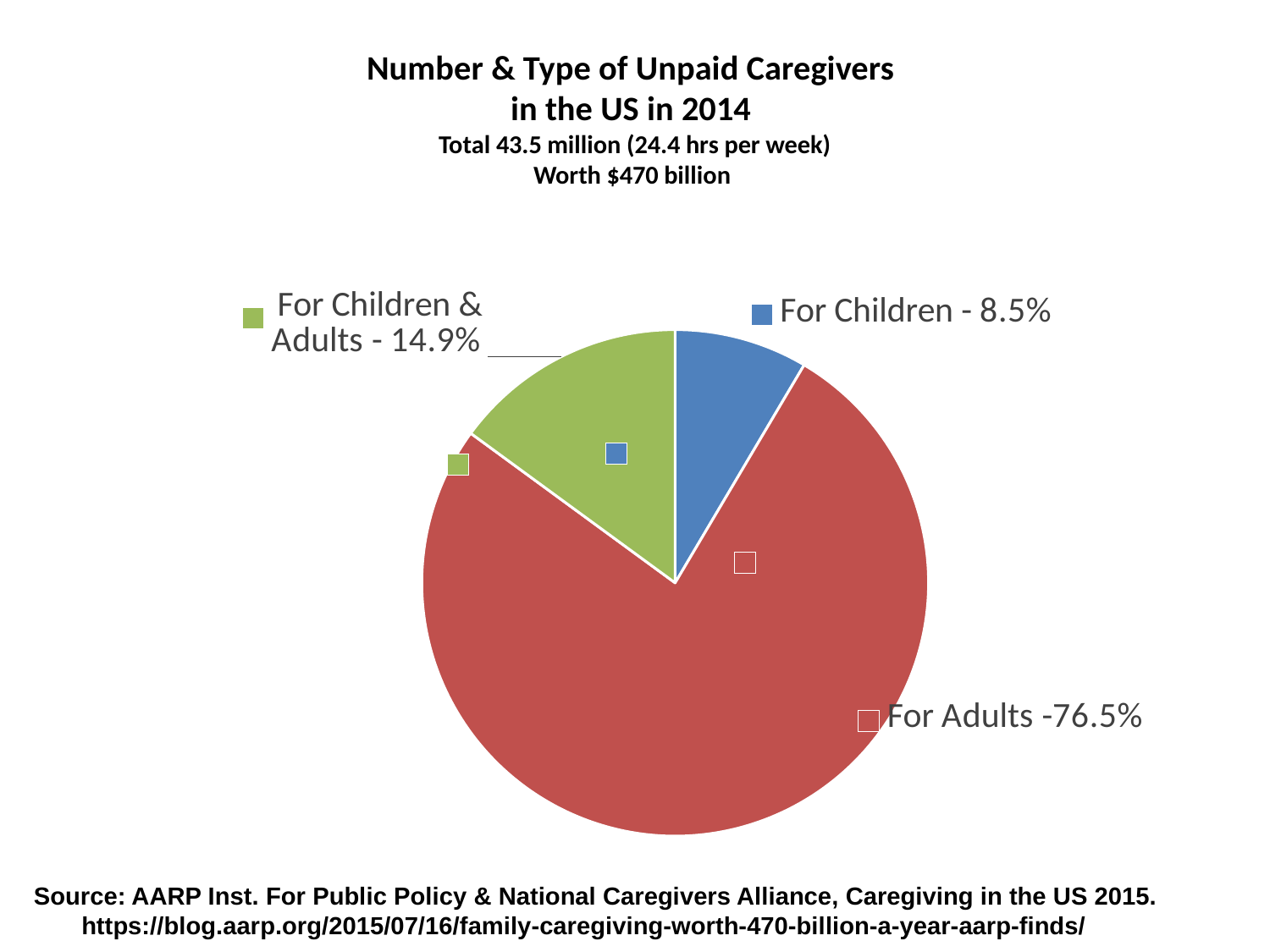
Which is larger, the share for 'For Children & Adults' or the share for 'For Children'? For Children & Adults What share of unpaid caregivers is labelled 'For Children'? 8.5% Which category has the largest slice of the pie? For Adults What total number of unpaid caregivers does the chart subtitle state? 43.5 million Which category has the smallest slice of the pie? For Children What is the difference in percentage points between the 'For Adults' share and the 'For Children & Adults' share? 61.6 What share of unpaid caregivers is labelled 'For Adults'? 76.5% What share of unpaid caregivers is labelled 'For Children & Adults'? 14.9% What kind of chart is shown on the slide? pie chart How many slices does the pie chart have? 3 What is the title of the chart? Number & Type of Unpaid Caregivers in the US in 2014 What is the difference in percentage points between the 'For Children & Adults' share and the 'For Children' share? 6.4